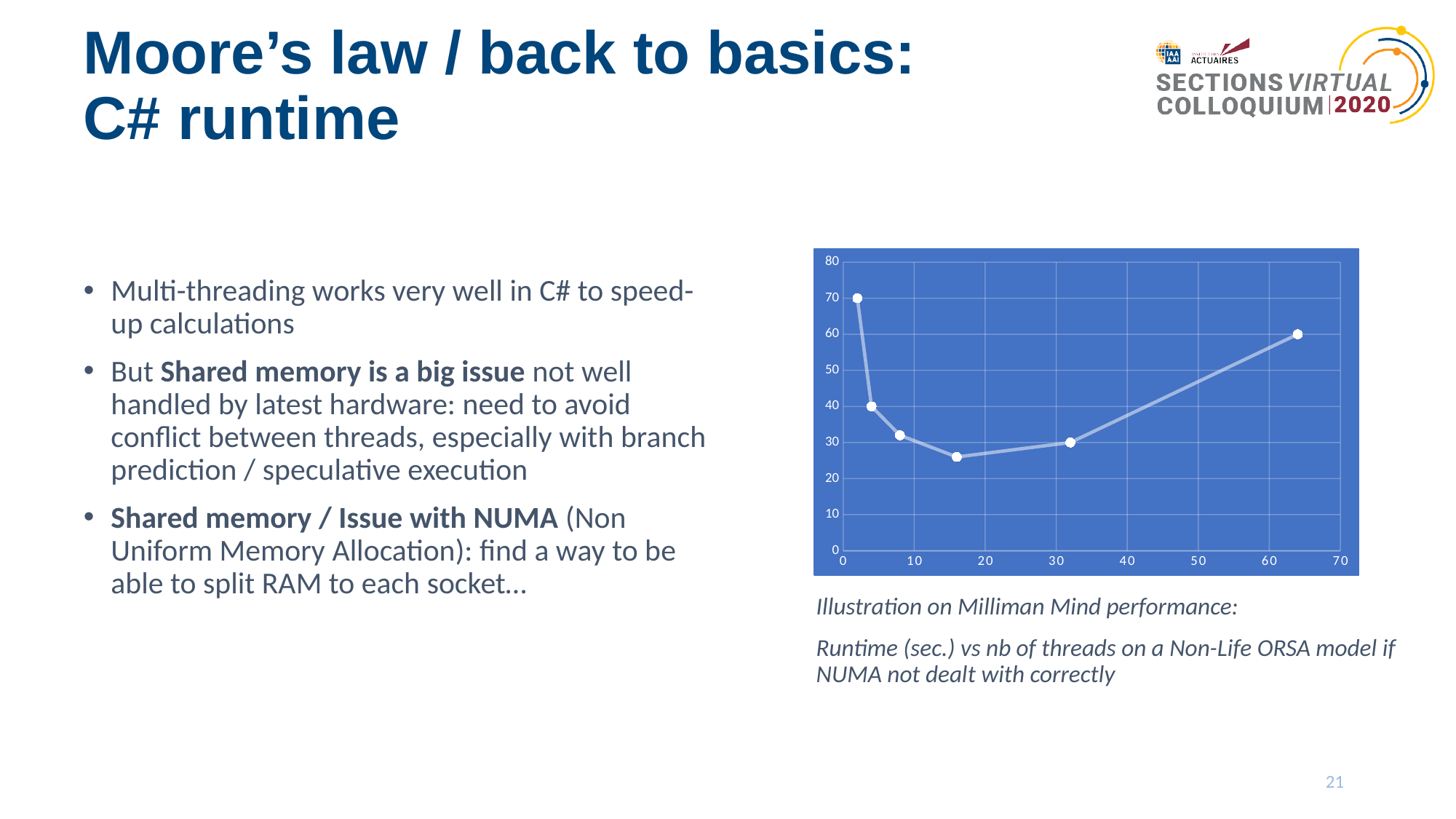
Does the plotted line rise or fall between the data point near x = 32 and the data point near x = 64? rise Does the plotted line rise or fall between the first and the fourth data point? fall What is the maximum value shown on the chart's y-axis? 80 Is the value of the lowest data point on the chart greater or less than 30? less According to the caption, what does the chart plot? Runtime (sec.) vs nb of threads Which data point has the highest value: the leftmost point or the rightmost point? the leftmost point Is the value of the data point near x = 32 greater or less than 40? less What is the y-axis value of the leftmost (first) data point on the chart? 70 Is the value of the second data point (near x = 4) greater or less than 50? less What is the y-axis value of the rightmost (last) data point on the chart? 60 What kind of chart is shown on the slide? line chart How many data points are plotted on the chart? 6